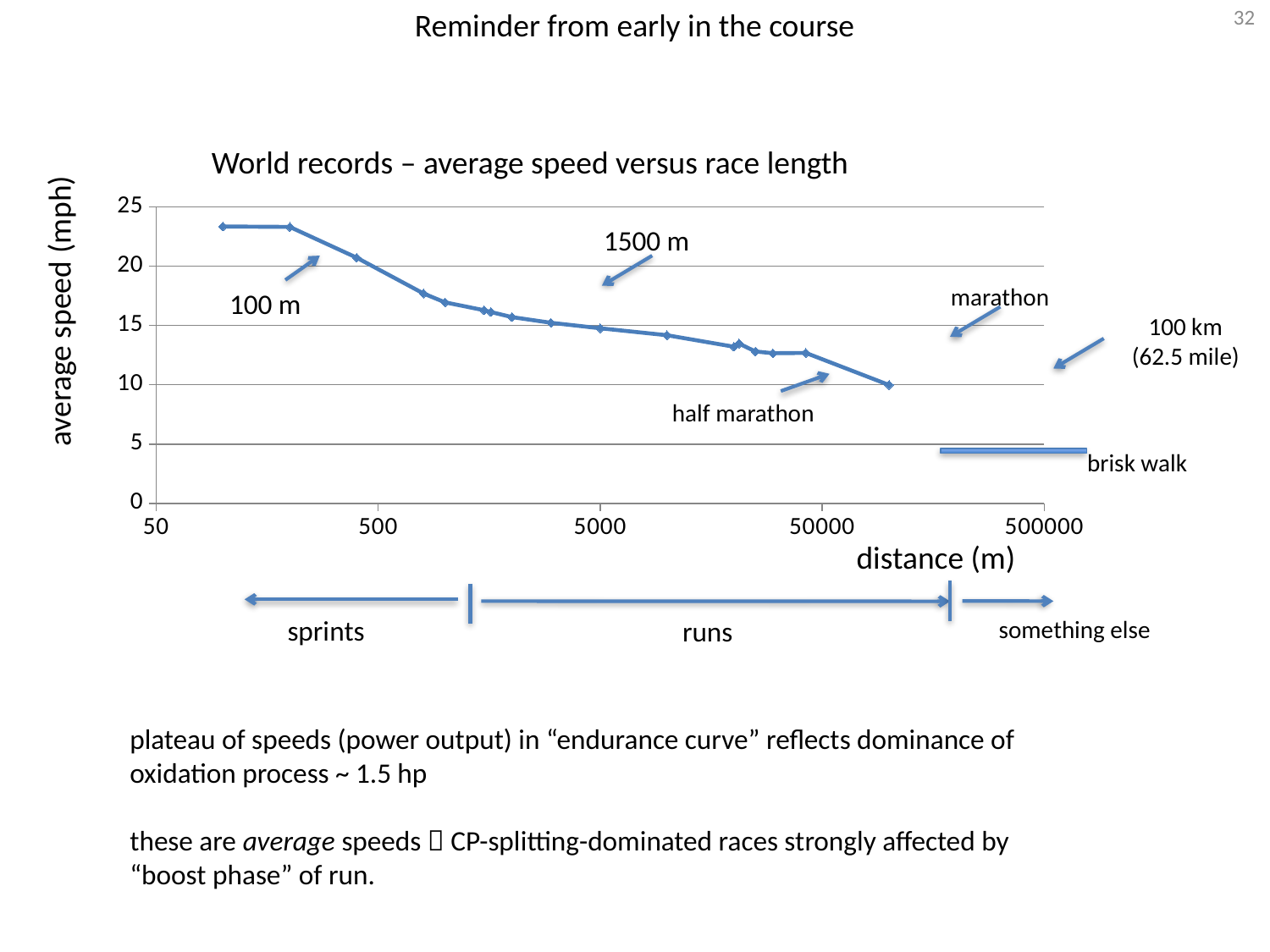
Is the average speed for the 1500 m race greater or less than 20 mph? less What is the label of the vertical axis of the chart? average speed (mph) Which labelled race has the lowest average speed on the chart? 100 km Is the average speed for the 100 m race greater or less than 20 mph? greater Which has the higher average speed, the 1500 m race or the half marathon? 1500 m Which has the higher average speed, the 100 m race or the marathon? 100 m As race distance increases along the x axis, does the average speed rise or fall? fall What is the title of the chart? World records – average speed versus race length What kind of chart is shown on the slide? line chart Is the average speed for the 100 km race greater or less than 15 mph? less